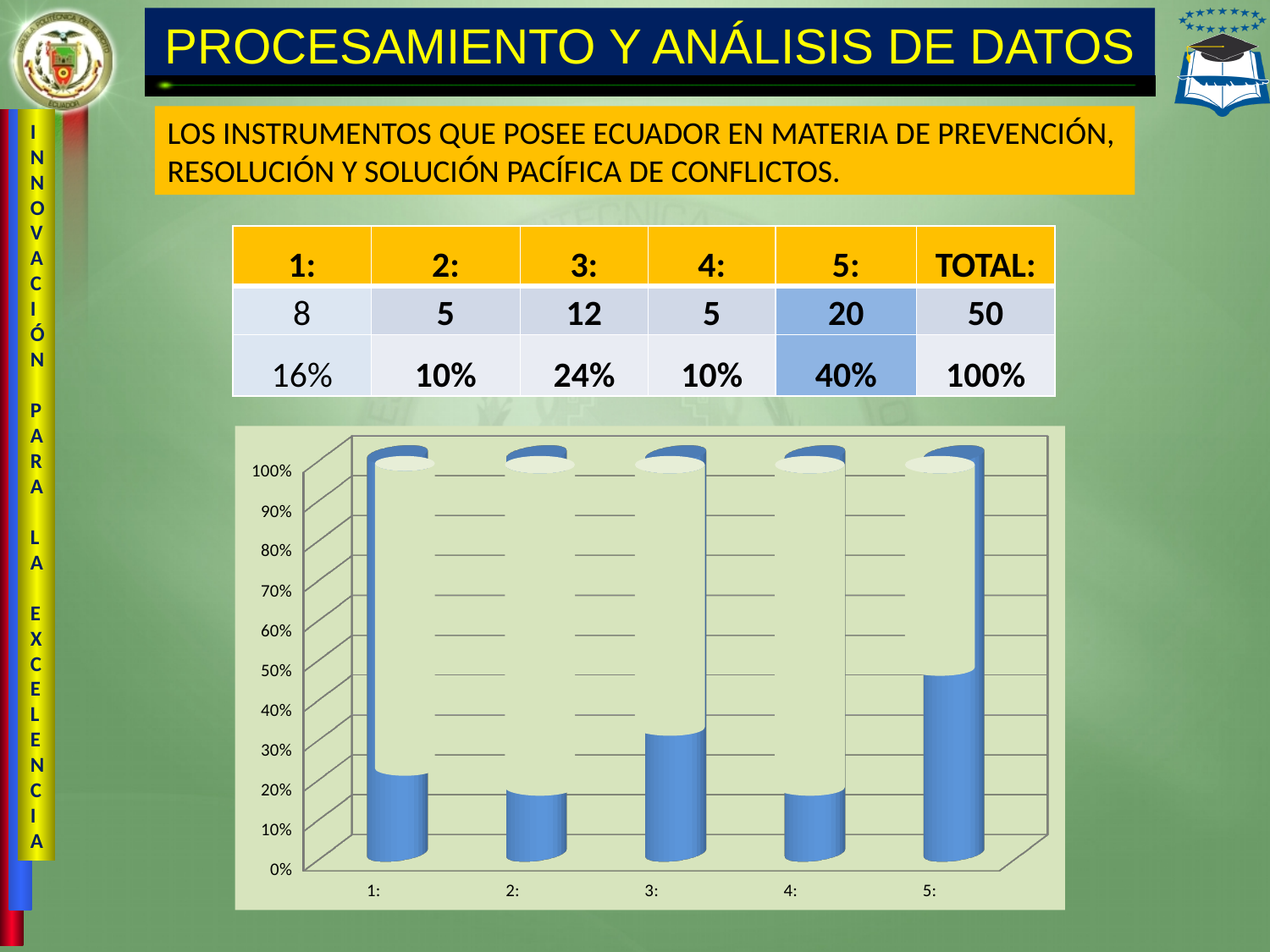
Is the blue bar for category 3: greater or less than 20%? greater Which has the taller blue bar, category 3: or category 1:? 3: What is the highest value shown on the chart's vertical axis? 100% How many categories are shown along the x axis of the chart? 5 What is the label of the first category on the chart's x axis? 1: Which category has the tallest blue bar in the chart? 5: Is the blue bar for category 5: greater or less than 30%? greater What kind of chart is shown on the slide? bar chart Is the blue bar for category 1: greater or less than 10%? greater Which has the taller blue bar, category 5: or category 3:? 5: